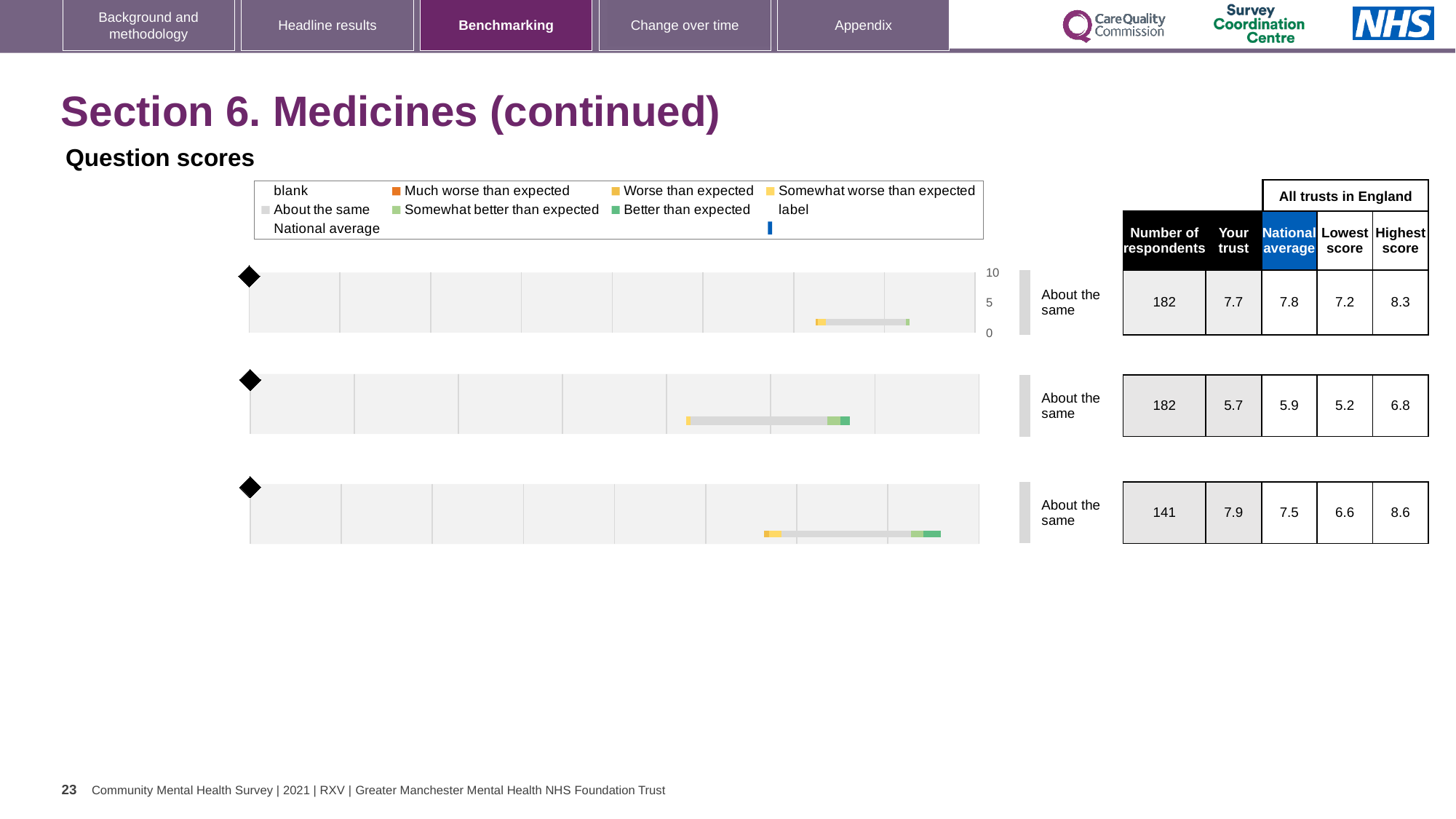
For the bottom chart, what is the 'Your trust' score? 7.9 For the bottom chart, what is the highest score among all trusts in England? 8.6 For the middle chart, which is larger: the 'Your trust' score or the national average? National average How many benchmarking charts are shown on the slide? 3 For the middle chart, how many respondents are there? 182 For the top chart, what is the difference between the highest score and the lowest score? 1.1 What kind of chart is used on this slide to show the question scores? bar chart For the top chart, what is the national average score? 7.8 For the bottom chart, how much higher is the 'Your trust' score than the national average? 0.4 For the top chart, what is the 'Your trust' score? 7.7 What benchmark category label is shown next to each of the three charts? About the same For the middle chart, what is the lowest score among all trusts in England? 5.2